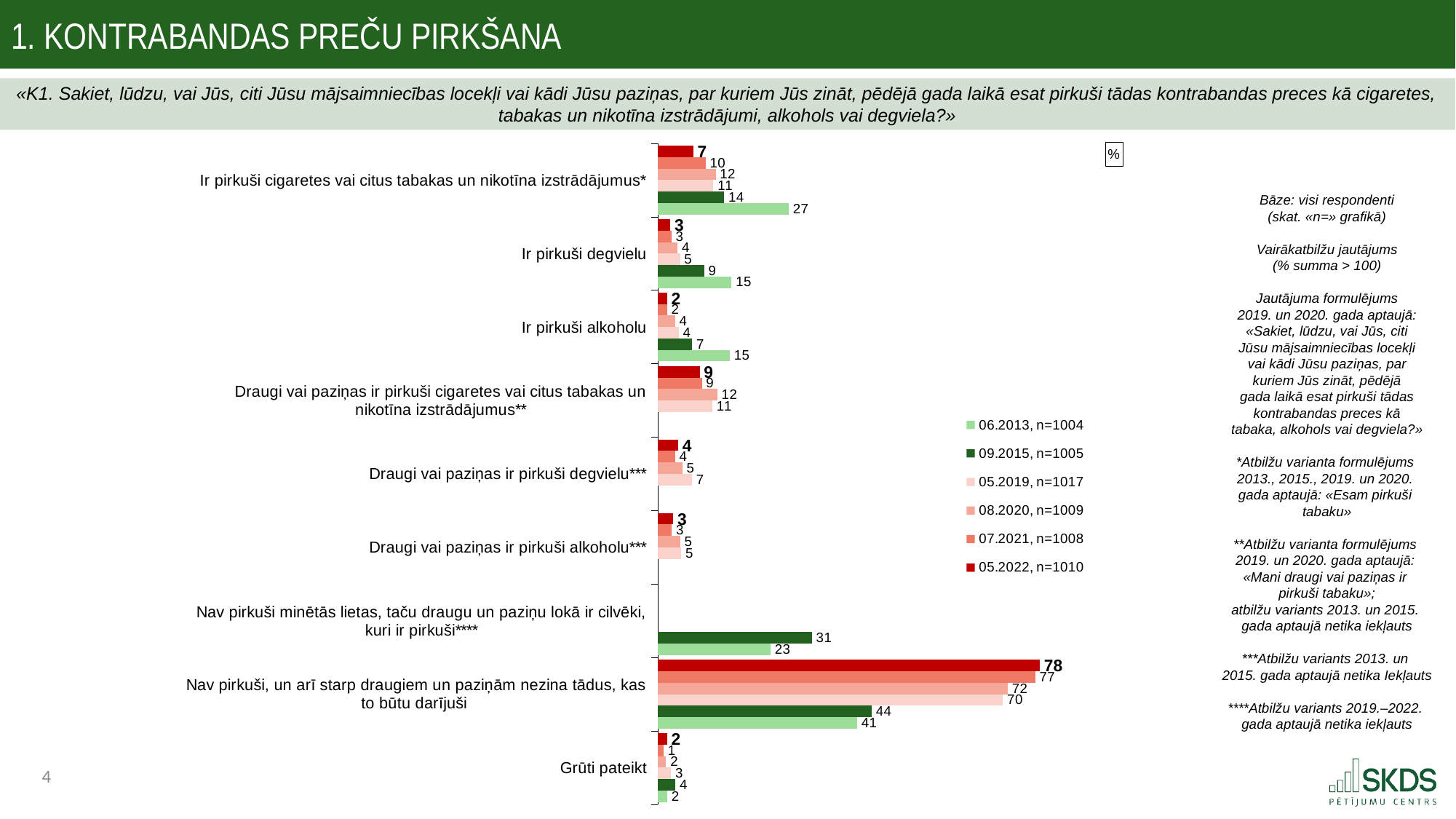
What is the 09.2015 value for "Nav pirkuši minētās lietas, taču draugu un paziņu lokā ir cilvēki, kuri ir pirkuši****"? 31 How many series does the legend list? 6 What is the 06.2013 value for "Nav pirkuši, un arī starp draugiem un paziņām nezina tādus, kas to būtu darījuši"? 41 Which category has the highest 05.2022 value? Nav pirkuši, un arī starp draugiem un paziņām nezina tādus, kas to būtu darījuši For the 09.2015 series, which is larger: "Ir pirkuši degvielu" or "Ir pirkuši alkoholu"? Ir pirkuši degvielu What is the 05.2022 value for "Ir pirkuši cigaretes vai citus tabakas un nikotīna izstrādājumus*"? 7 How many categories are shown on the chart? 9 For "Nav pirkuši, un arī starp draugiem un paziņām nezina tādus, kas to būtu darījuši", do the values rise or fall from 06.2013 to 05.2022? Rise What is the 05.2019 value for "Draugi vai paziņas ir pirkuši degvielu***"? 7 What is the difference between the 06.2013 and 05.2022 values for "Ir pirkuši cigaretes vai citus tabakas un nikotīna izstrādājumus*"? 20 What kind of chart is shown on the slide? Bar chart What is the difference between the 05.2022 and 07.2021 values for "Nav pirkuši, un arī starp draugiem un paziņām nezina tādus, kas to būtu darījuši"? 1